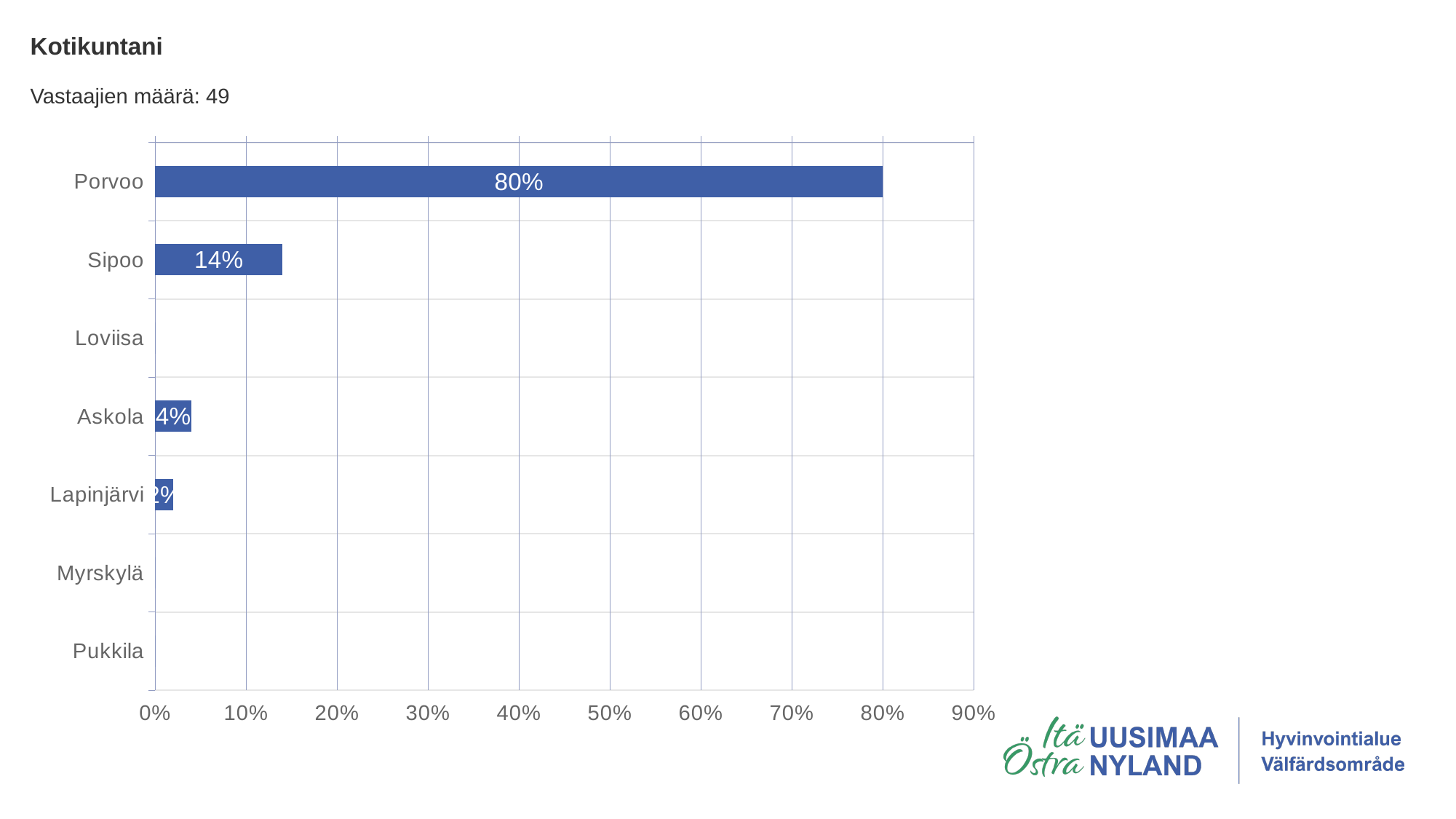
What is the value for Sipoo? 14% Which category has the highest value? Porvoo What is the value for Askola? 4% Is the value for Porvoo greater or less than 70%? greater What is the value for Lapinjärvi? 2% What is the title of the chart? Kotikuntani What is the difference between the values for Porvoo and Sipoo? 66% What is the value for Porvoo? 80% Which is larger, the value for Sipoo or the value for Askola? Sipoo What kind of chart is shown on the slide? bar chart How many categories are shown on the y axis? 7 What is the difference between the values for Sipoo and Askola? 10%